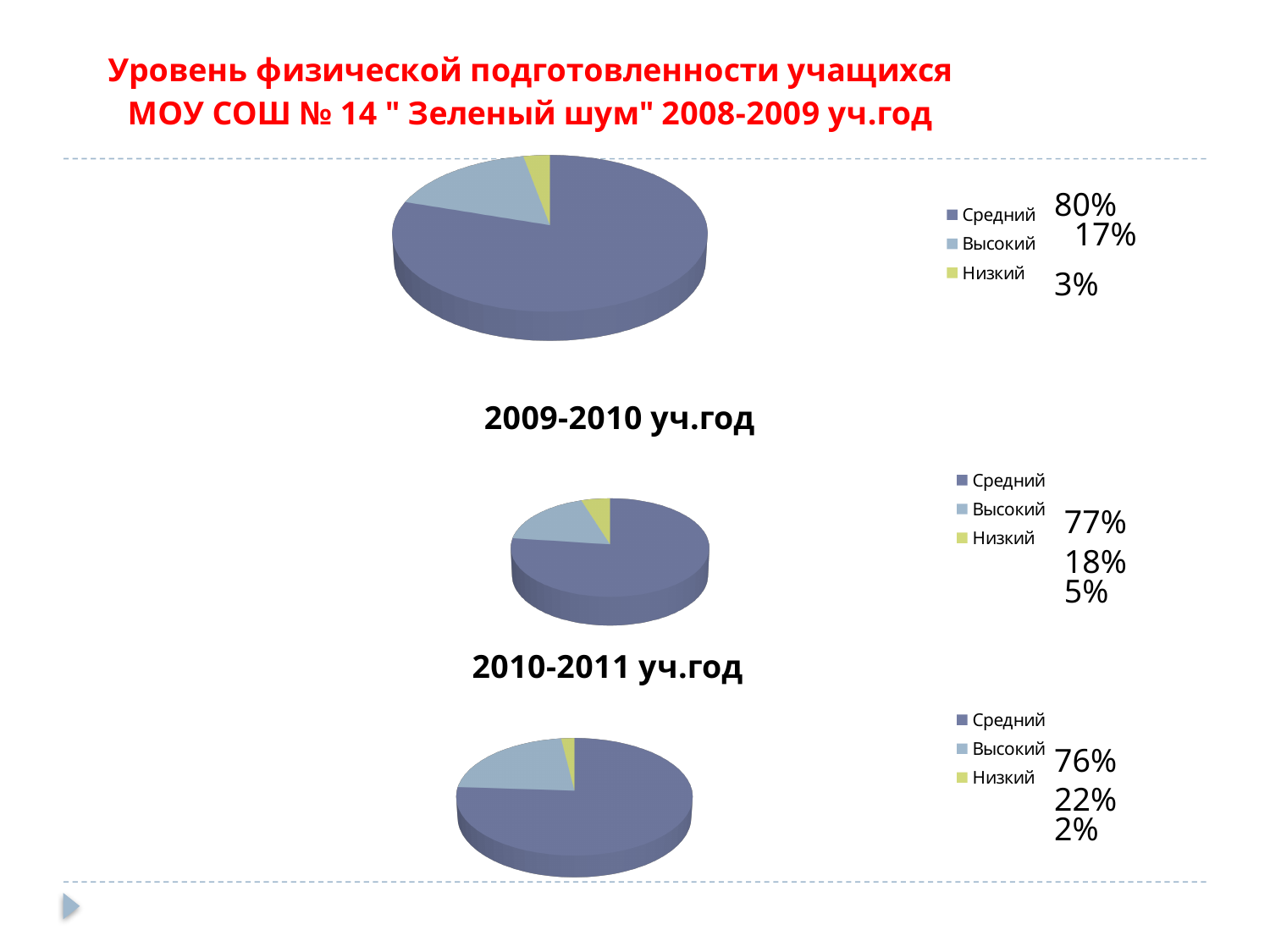
In the bottom pie chart (2010-2011 уч.год), what is the difference between the Средний and Высокий shares? 54% How many entries does the legend of the top pie chart list? 3 In the top pie chart (2008-2009 уч.год), what share is labelled for Низкий? 3% What type of chart is used for the 2010-2011 уч.год data? Pie chart In the middle pie chart (2009-2010 уч.год), what share is labelled for Высокий? 18% In the middle pie chart (2009-2010 уч.год), which category has the largest slice? Средний In the bottom pie chart (2010-2011 уч.год), what share is labelled for Высокий? 22% Is the Низкий share larger in the middle pie chart (2009-2010 уч.год) or in the bottom pie chart (2010-2011 уч.год)? 2009-2010 уч.год In the top pie chart (2008-2009 уч.год), which category has the smallest slice? Низкий In the bottom pie chart (2010-2011 уч.год), what share is labelled for Низкий? 2% How many pie charts are shown on the slide? 3 In the top pie chart (2008-2009 уч.год), what share is labelled for Средний? 80%